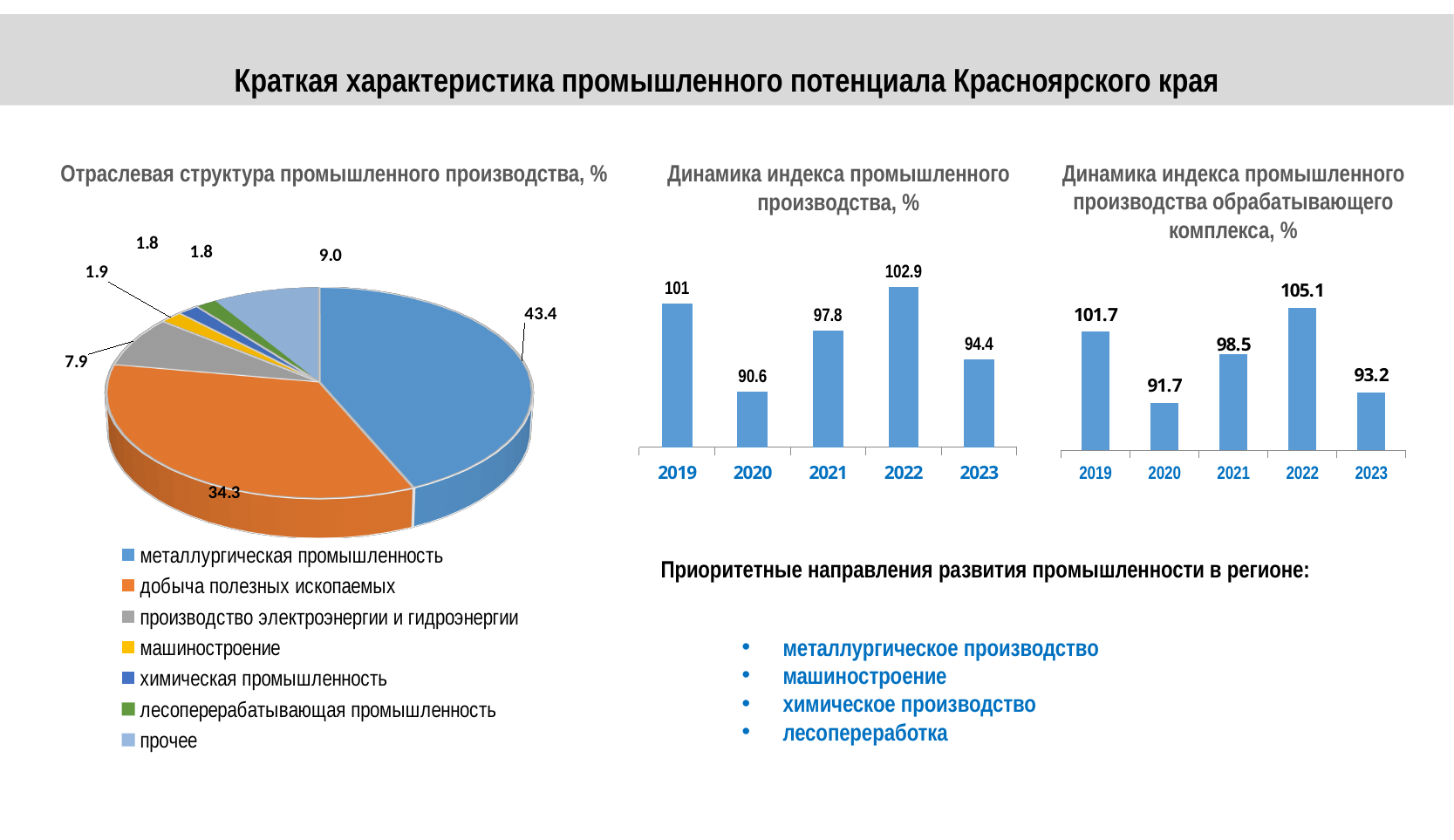
In the chart 'Динамика индекса промышленного производства обрабатывающего комплекса, %', what is the value for 2019? 101.7 In the pie chart 'Отраслевая структура промышленного производства, %', what share does металлургическая промышленность have? 43.4 In the pie chart 'Отраслевая структура промышленного производства, %', how many categories does the legend list? 7 In the chart 'Динамика индекса промышленного производства, %', what is the difference between the values for 2022 and 2020? 12.3 In the pie chart 'Отраслевая структура промышленного производства, %', what is the difference between the shares of металлургическая промышленность and добыча полезных ископаемых? 9.1 In the pie chart 'Отраслевая структура промышленного производства, %', what share does добыча полезных ископаемых have? 34.3 In the chart 'Динамика индекса промышленного производства, %', which year has the lowest value? 2020 In the chart 'Динамика индекса промышленного производства обрабатывающего комплекса, %', which year has the highest value? 2022 In the chart 'Динамика индекса промышленного производства, %', what is the value for 2022? 102.9 What type of chart is 'Динамика индекса промышленного производства, %'? bar chart In the pie chart 'Отраслевая структура промышленного производства, %', which category has the largest share? металлургическая промышленность In the chart 'Динамика индекса промышленного производства обрабатывающего комплекса, %', is the value for 2021 larger or smaller than the value for 2023? larger